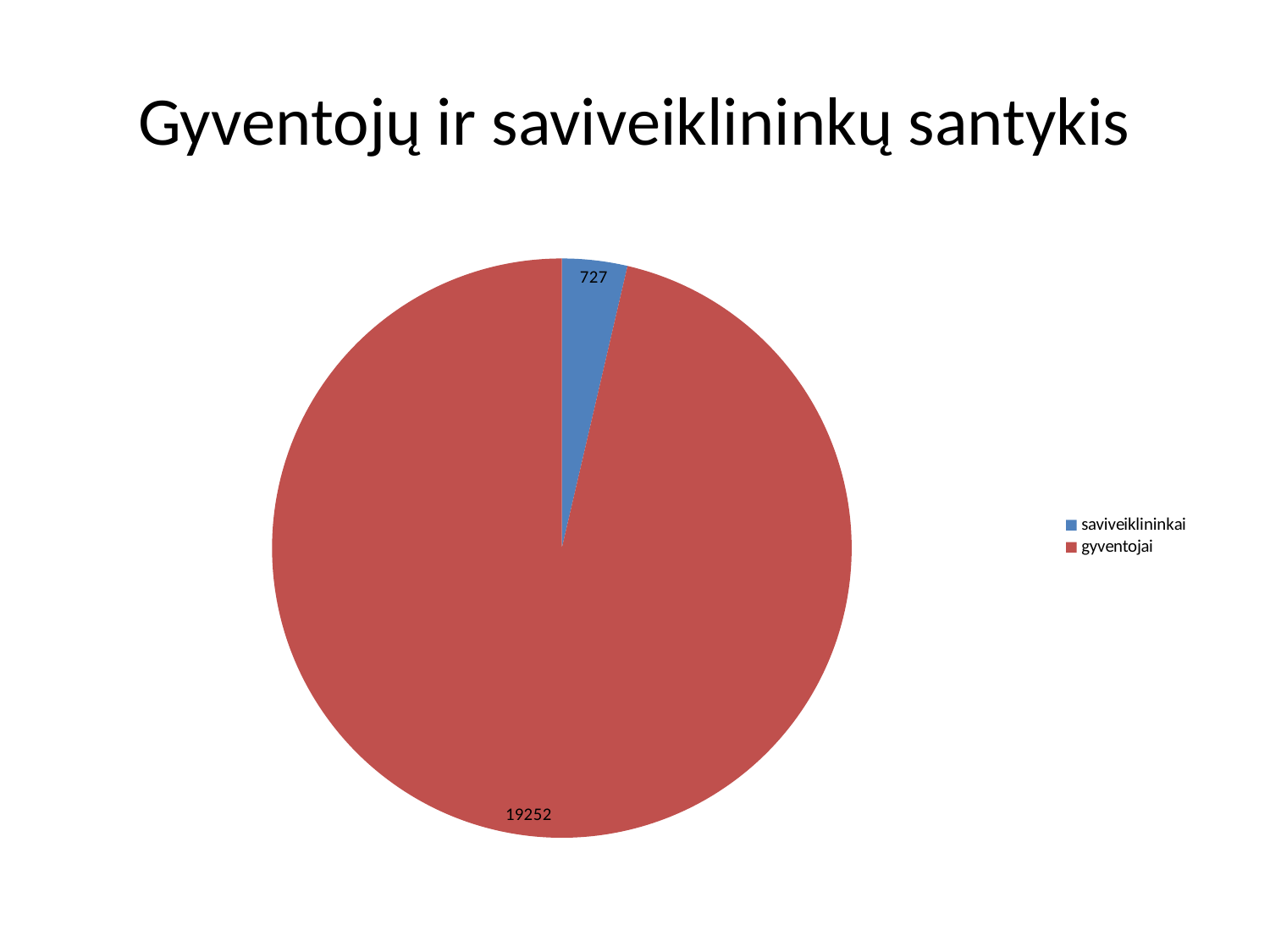
What is the title of the chart? Gyventojų ir saviveiklininkų santykis What is the difference between the values for gyventojai and saviveiklininkai? 18525 Which is larger, the value for gyventojai or the value for saviveiklininkai? gyventojai What colour is the slice for saviveiklininkai? blue How many entries does the legend list? 2 What is the value for gyventojai? 19252 How many slices does the pie chart have? 2 What type of chart is shown on the slide? pie chart What is the value for saviveiklininkai? 727 What is the total of the two values shown in the pie chart? 19979 Which category has the smallest slice of the pie? saviveiklininkai Which category has the largest slice of the pie? gyventojai